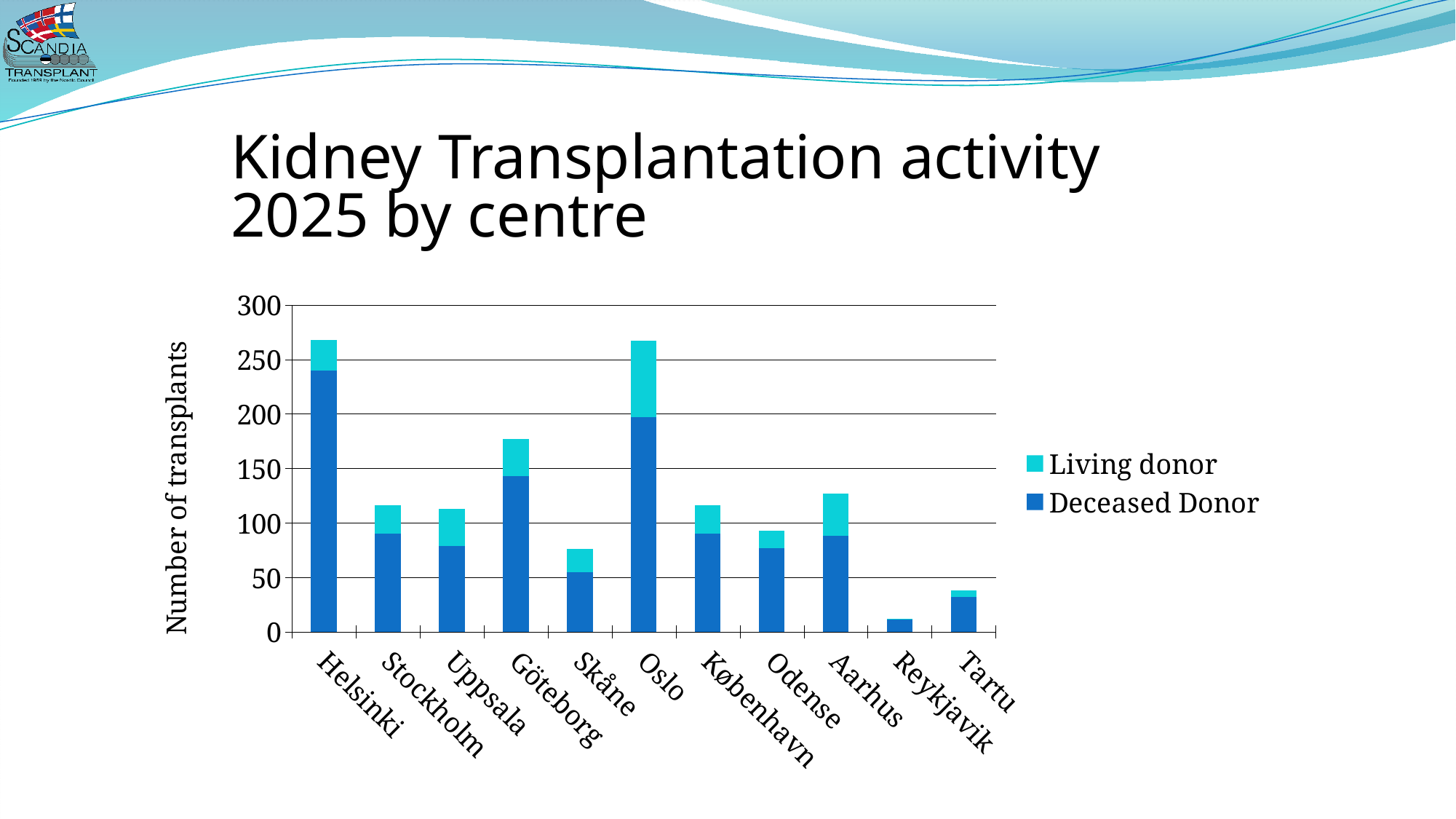
How many series does the chart legend list? 2 Is the total number of transplants for Tartu greater or less than 50? less Which centre has the lowest total number of transplants? Reykjavik Is the total number of transplants for Skåne greater or less than 100? less What is the label on the vertical axis of the chart? Number of transplants Is the total number of transplants for Helsinki greater or less than 250? greater What kind of chart is shown on the slide? Stacked bar chart How many centres are shown on the x axis of the chart? 11 Which centre has a larger total number of transplants, Aarhus or Odense? Aarhus Which centre has the highest number of living donor transplants? Oslo Which centre has the highest number of deceased donor transplants? Helsinki